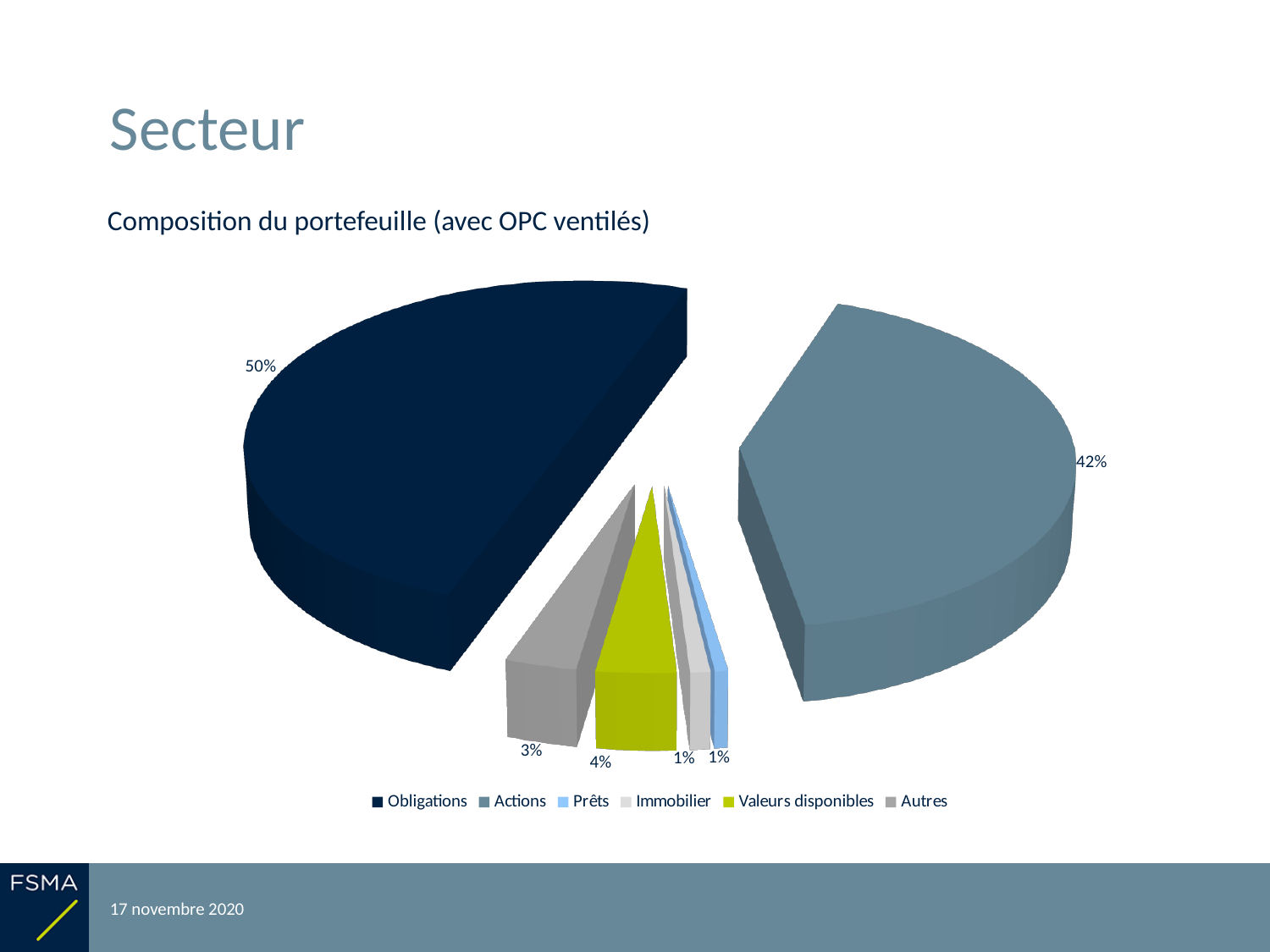
What kind of chart is shown on the slide? pie chart What share of the portfolio is Valeurs disponibles? 4% What share of the portfolio is Autres? 3% Which category has the largest share of the pie? Obligations What share of the portfolio is Actions? 42% What share of the portfolio is Prêts? 1% What is the difference in percentage points between Obligations and Actions? 8 What is the subtitle of the chart? Composition du portefeuille (avec OPC ventilés) Which is larger, the share for Valeurs disponibles or the share for Autres? Valeurs disponibles What colour is the Valeurs disponibles slice? yellow-green How many categories does the legend list? 6 What share of the portfolio is Obligations? 50%